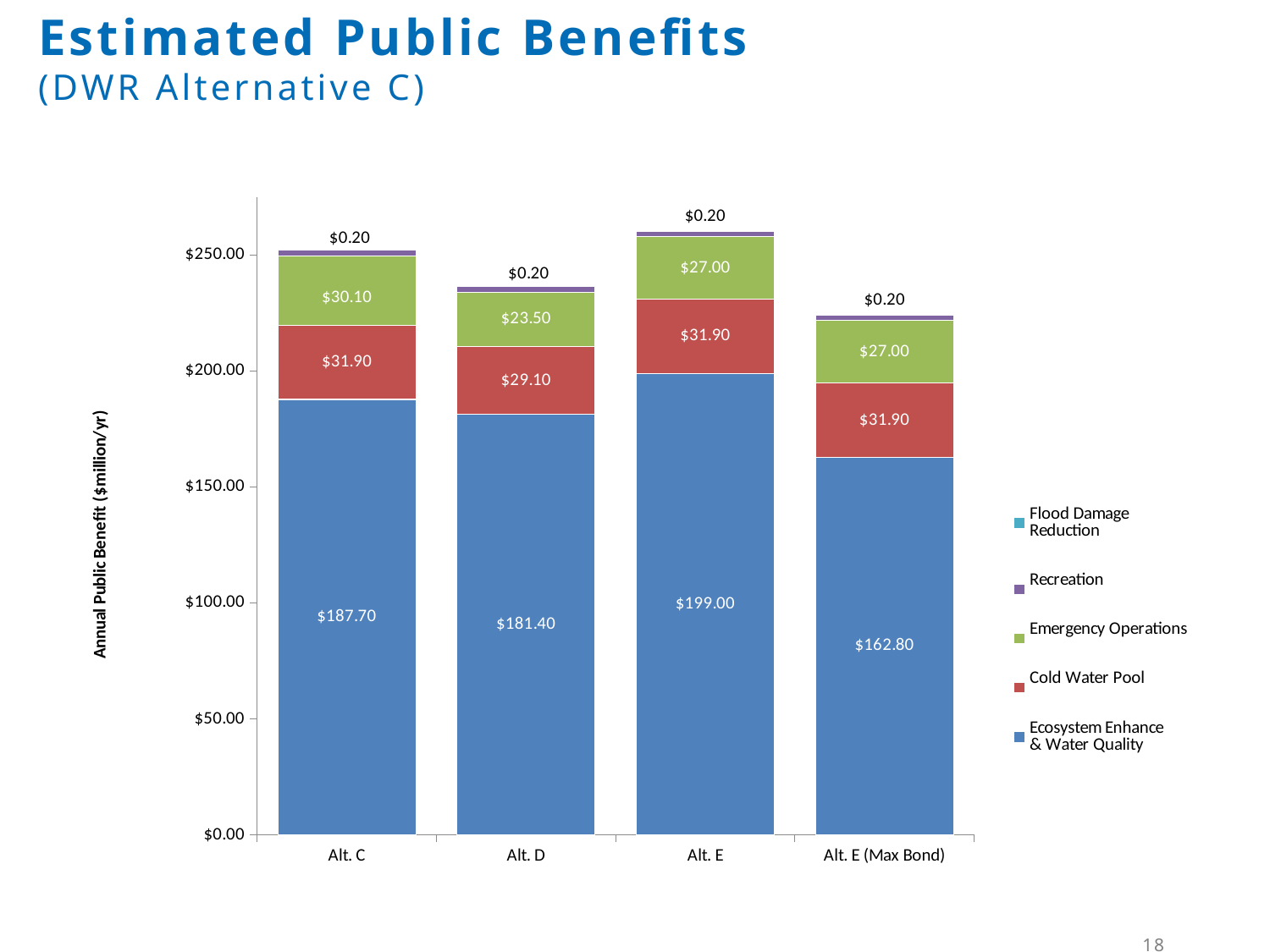
What is the Emergency Operations value for Alt. C? $30.10 What is the Ecosystem Enhance & Water Quality value for Alt. E? $199.00 What type of chart is shown on the slide? Stacked bar chart Which has the larger Emergency Operations value, Alt. C or Alt. D? Alt. C What is the Cold Water Pool value for Alt. D? $29.10 What is the title of the y axis? Annual Public Benefit ($million/yr) How many series does the legend list? 5 Is the total height of the Alt. E (Max Bond) bar greater or less than $250.00? less What is the difference between the Ecosystem Enhance & Water Quality values for Alt. C and Alt. D? $6.30 Which alternative has the highest Ecosystem Enhance & Water Quality value? Alt. E Which alternative has the lowest Ecosystem Enhance & Water Quality value? Alt. E (Max Bond) How many alternatives (categories) are shown on the x axis? 4